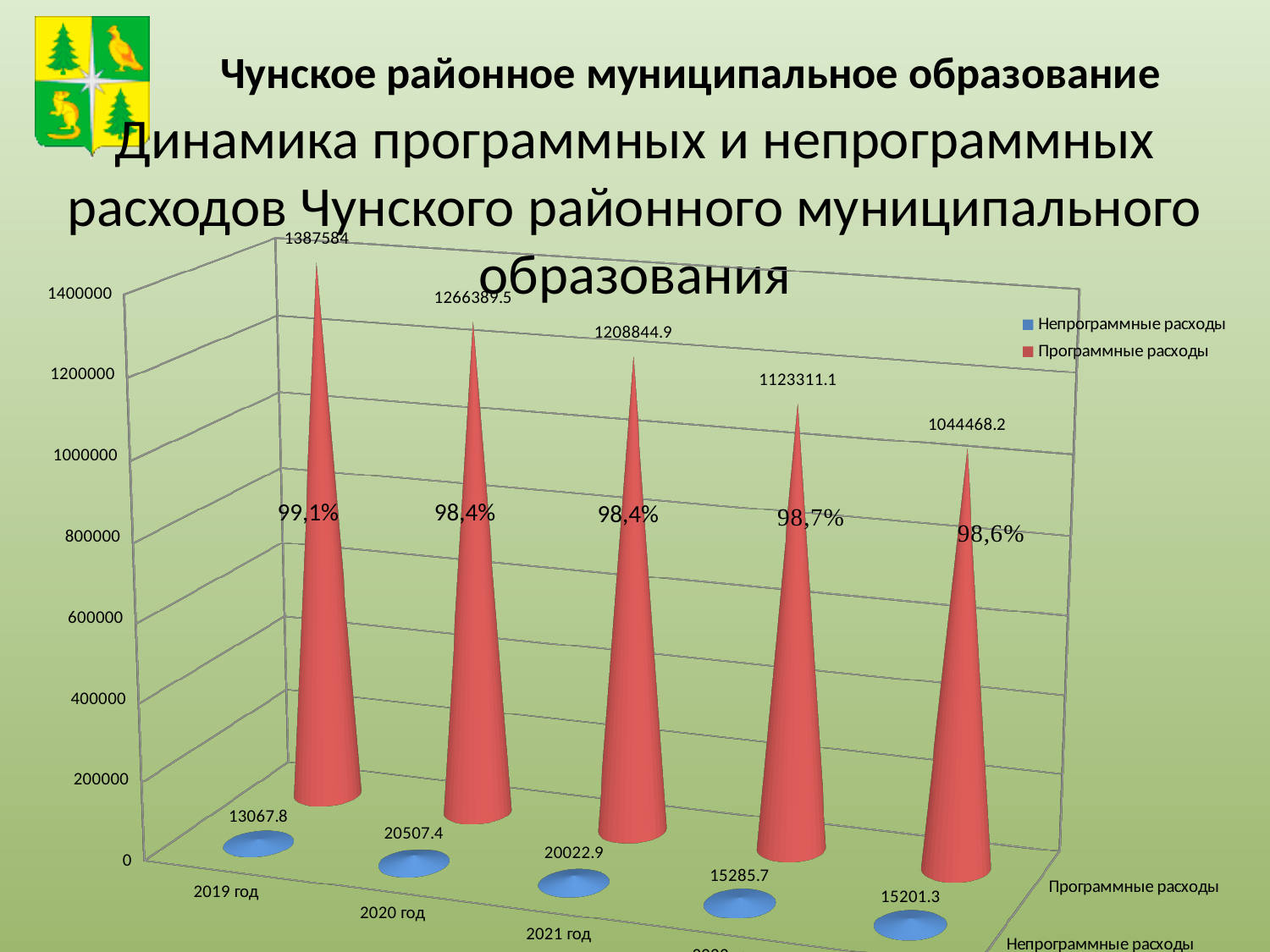
What is the value of Непрограммные расходы for 2020 год? 20507.4 What percentage is shown above the Программные расходы cone for 2019 год? 99,1% What is the difference between Программные расходы in 2019 год and 2020 год? 121194.5 Which is larger: Непрограммные расходы in 2020 год or in 2021 год? 2020 год Which year has the highest value of Программные расходы? 2019 год What is the value of Непрограммные расходы for 2019 год? 13067.8 Which year has the lowest value of Непрограммные расходы? 2019 год What is the value of Программные расходы for 2019 год? 1387584 What colour represents Непрограммные расходы in the chart? blue How many series does the legend list? 2 Do the values of Программные расходы rise or fall from left to right along the x axis? fall What is the value of Программные расходы for 2021 год? 1208844.9